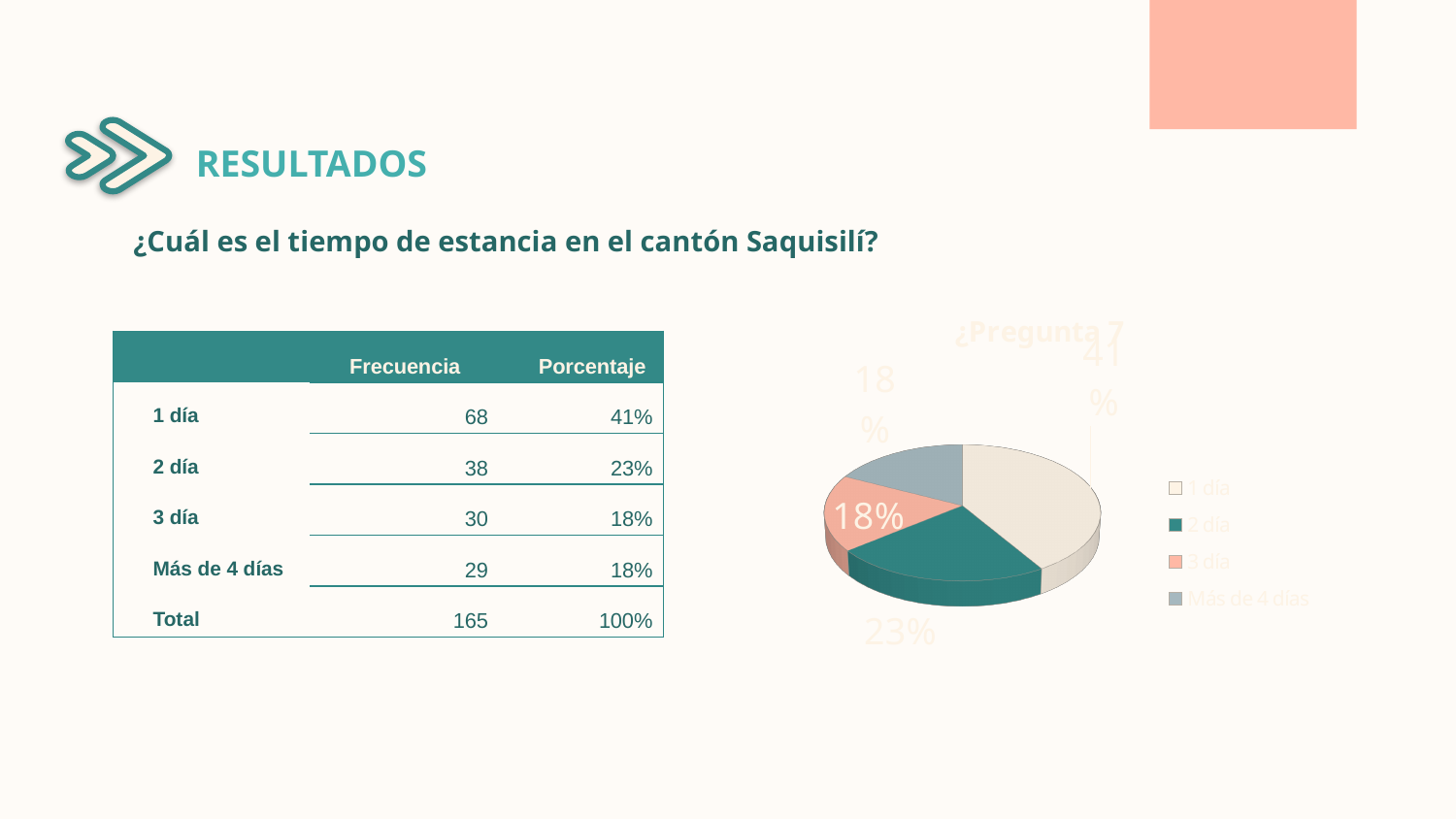
How many slices does the pie chart have? 4 What percentage share does the '2 día' slice represent? 23% How many entries does the pie chart's legend list? 4 Which is larger, the slice for '1 día' or the slice for '2 día'? 1 día Which legend entry is listed last in the pie chart's legend? Más de 4 días What is the total frequency across all categories? 165 What percentage share does the '3 día' slice represent? 18% What is the frequency value for 'Más de 4 días'? 29 Which category has the largest slice in the pie chart? 1 día What kind of chart is shown on the slide? pie chart What is the difference in percentage points between the '1 día' slice and the '2 día' slice? 18% What percentage share does the '1 día' slice represent? 41%